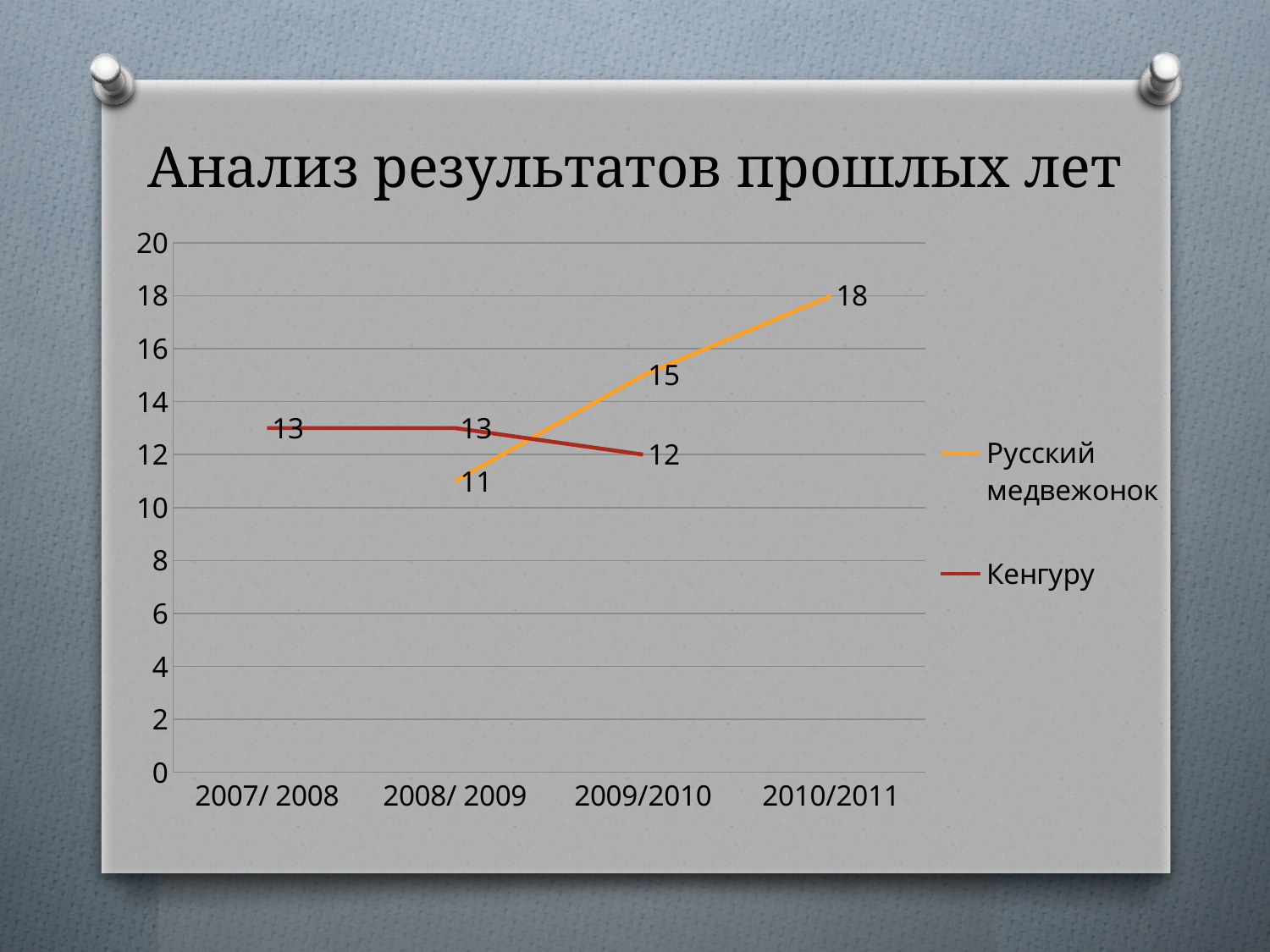
What is the value for Кенгуру in 2009/2010? 12 Which series has the larger value in 2008/2009, Русский медвежонок or Кенгуру? Кенгуру In which year is the value for Кенгуру lowest? 2009/2010 What is the difference between Русский медвежонок and Кенгуру in 2009/2010? 3 How many series does the legend list? 2 How many categories are shown on the x axis? 4 Does the value for Русский медвежонок rise or fall from 2008/2009 to 2010/2011? rise In which year is the value for Русский медвежонок highest? 2010/2011 What is the value for Русский медвежонок in 2008/2009? 11 What is the value for Русский медвежонок in 2010/2011? 18 What is the title of the chart? Анализ результатов прошлых лет What type of chart is shown on the slide? line chart